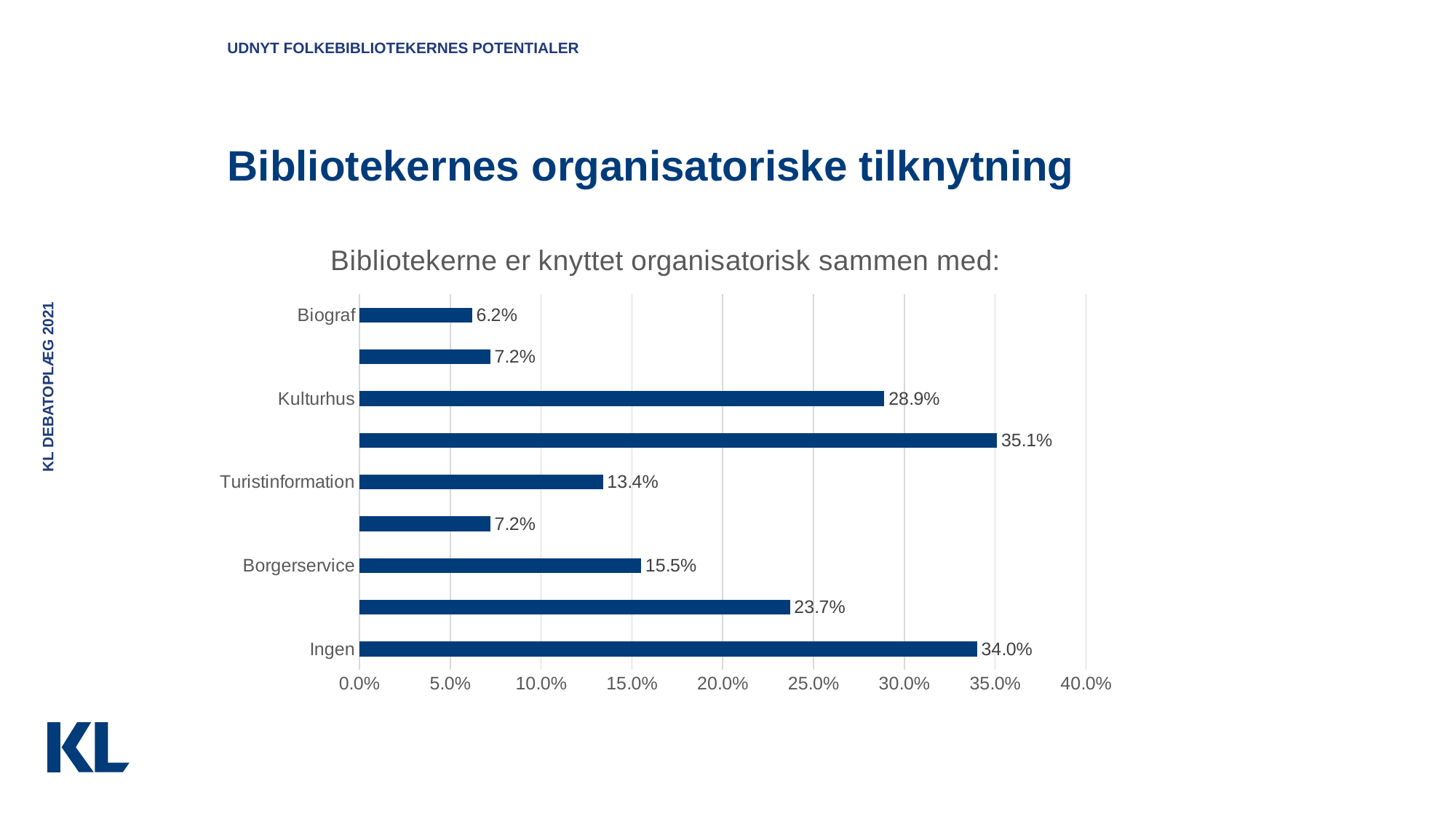
What kind of chart is shown on the slide? Bar chart What is the value for Borgerservice? 15.5% What is the value for Biograf? 6.2% Is the value for Ingen greater or less than 30.0%? greater What is the value for Ingen? 34.0% What is the value for Kulturhus? 28.9% What is the difference between the values for Borgerservice and Turistinformation? 2.1 percentage points What is the difference between the values for Ingen and Kulturhus? 5.1 percentage points Which is larger, the value for Kulturhus or the value for Borgerservice? Kulturhus What is the value for Turistinformation? 13.4% Which category has the lowest value? Biograf How many bars are plotted in the chart? 9